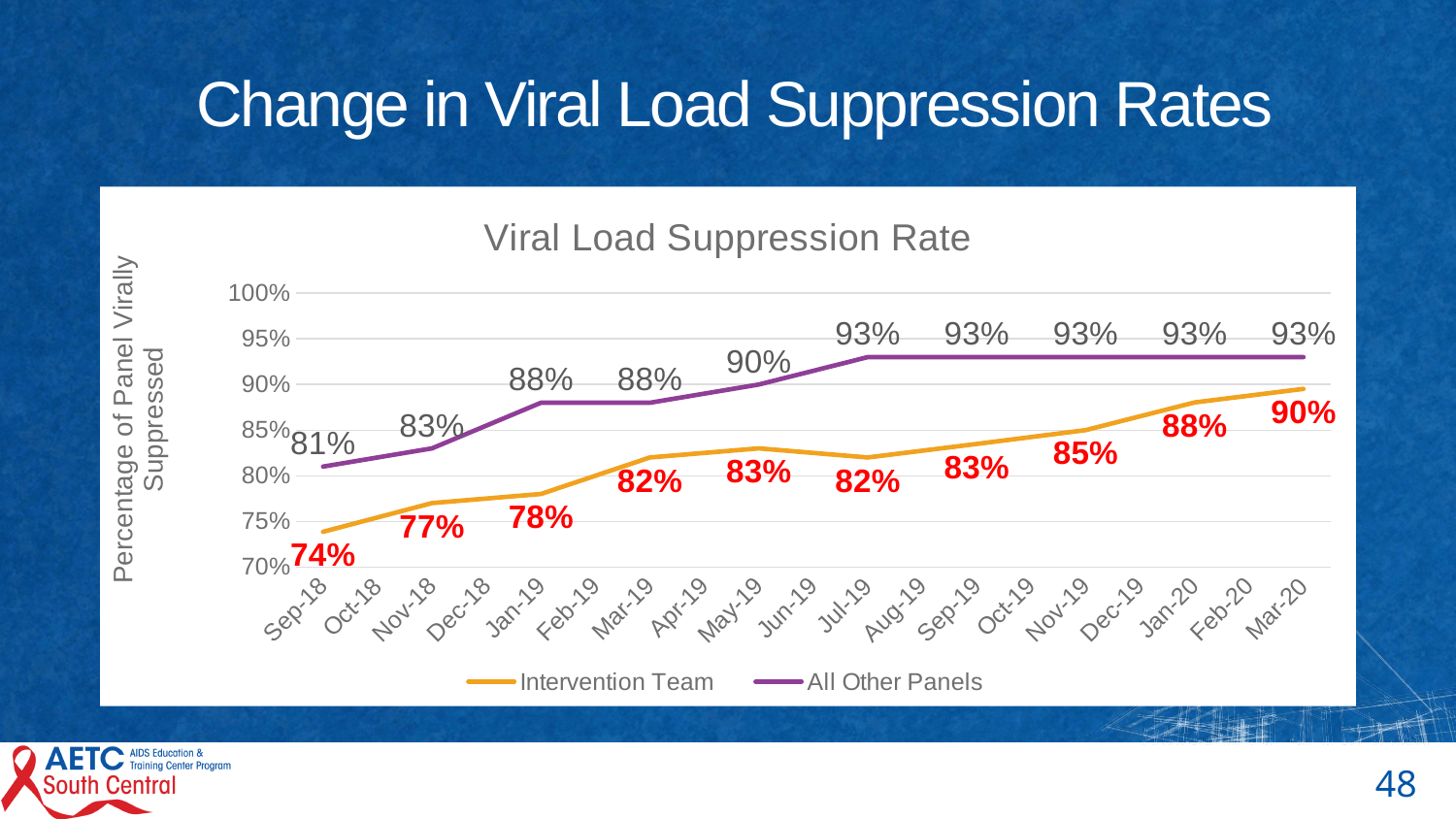
What is the title of the y axis? Percentage of Panel Virally Suppressed What is the viral load suppression rate for the Intervention Team in Nov-19? 85% In Jan-19, which series has the higher suppression rate, Intervention Team or All Other Panels? All Other Panels In which month does the Intervention Team reach its highest labelled suppression rate? Mar-20 What is the difference between All Other Panels and the Intervention Team in Mar-20? 3 percentage points What kind of chart is shown on the slide? Line chart What is the difference between All Other Panels and the Intervention Team in Sep-18? 7 percentage points What is the viral load suppression rate for All Other Panels in Mar-20? 93% Does the Intervention Team's suppression rate generally rise or fall from Sep-18 to Mar-20? Rise How many series does the legend list? 2 How many months are shown on the x axis? 19 What is the viral load suppression rate for the Intervention Team in Sep-18? 74%